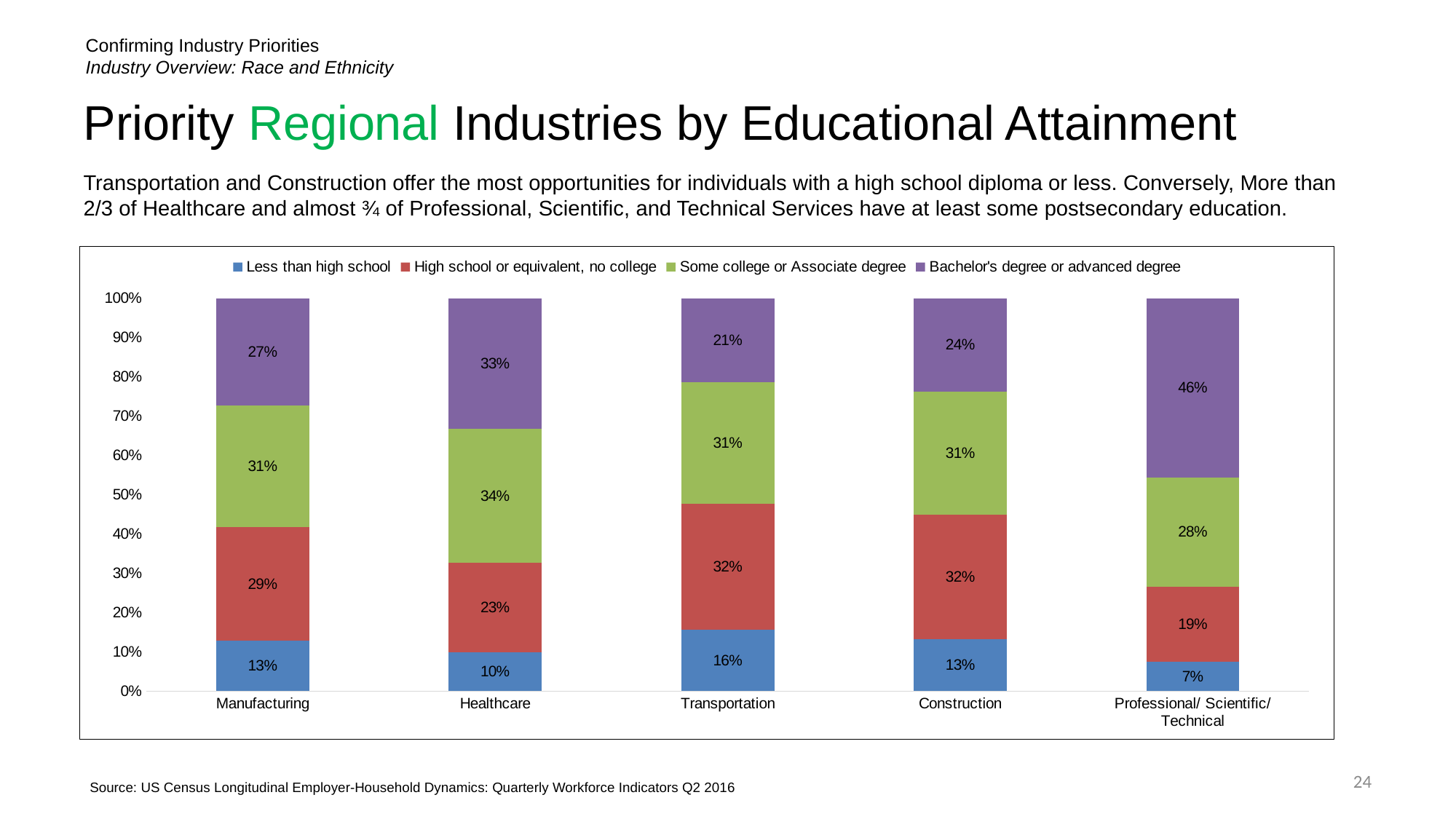
What is the difference between the Bachelor's degree or advanced degree share in Professional/ Scientific/ Technical and in Transportation? 25% How many series does the legend list? 4 Which industry has the highest share of workers with a Bachelor's degree or advanced degree? Professional/ Scientific/ Technical What kind of chart is shown on the slide? Stacked bar chart What is the combined share of Less than high school and High school or equivalent, no college in Construction? 45% How many industries are shown on the x axis? 5 Which colour represents Some college or Associate degree in the legend? Green Which industry has the lowest share of workers with Less than high school? Professional/ Scientific/ Technical What share of Professional/ Scientific/ Technical workers have Some college or Associate degree? 28% What is the value for Less than high school in Transportation? 16% What percentage of Healthcare workers have a Bachelor's degree or advanced degree? 33% Which is larger: the High school or equivalent, no college share in Manufacturing or in Healthcare? Manufacturing